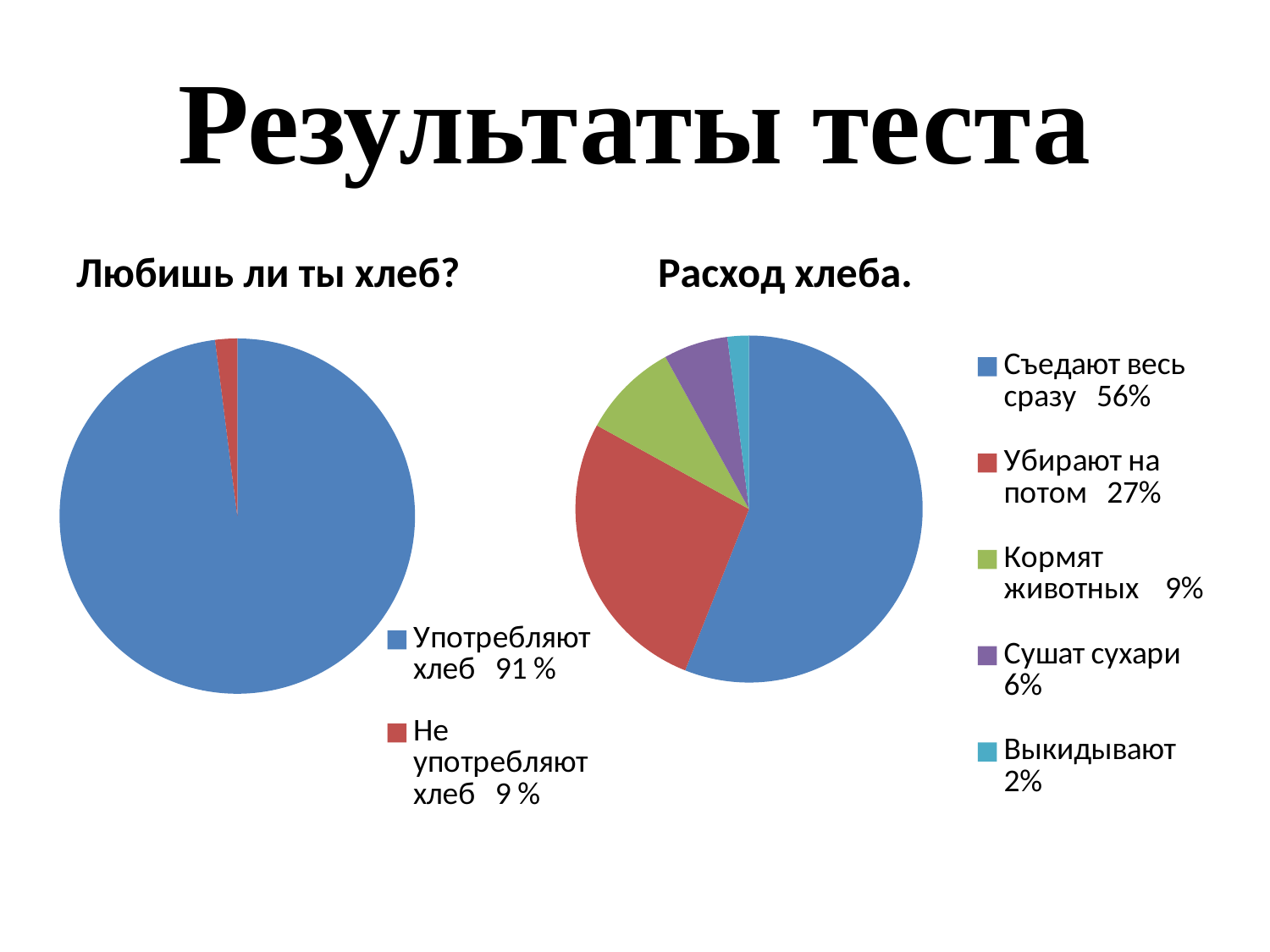
In the chart titled "Расход хлеба.", which category has the largest slice? Съедают весь сразу In the chart titled "Расход хлеба.", which category has the smallest slice? Выкидывают In the chart titled "Любишь ли ты хлеб?", which category has the larger slice? Употребляют хлеб What kind of chart is the chart titled "Любишь ли ты хлеб?"? pie chart In the chart titled "Расход хлеба.", which is larger: the share for "Кормят животных" or the share for "Сушат сухари"? Кормят животных In the chart titled "Любишь ли ты хлеб?", what share is shown for "Не употребляют хлеб"? 9 % In the chart titled "Расход хлеба.", what share is shown for "Сушат сухари"? 6% In the chart titled "Любишь ли ты хлеб?", what share is shown for "Употребляют хлеб"? 91 % In the chart titled "Расход хлеба.", what is the difference between the shares for "Съедают весь сразу" and "Убирают на потом"? 29% In the chart titled "Расход хлеба.", what share is shown for "Убирают на потом"? 27% How many categories does the legend of the chart titled "Расход хлеба." list? 5 In the chart titled "Расход хлеба.", what share is shown for "Съедают весь сразу"? 56%